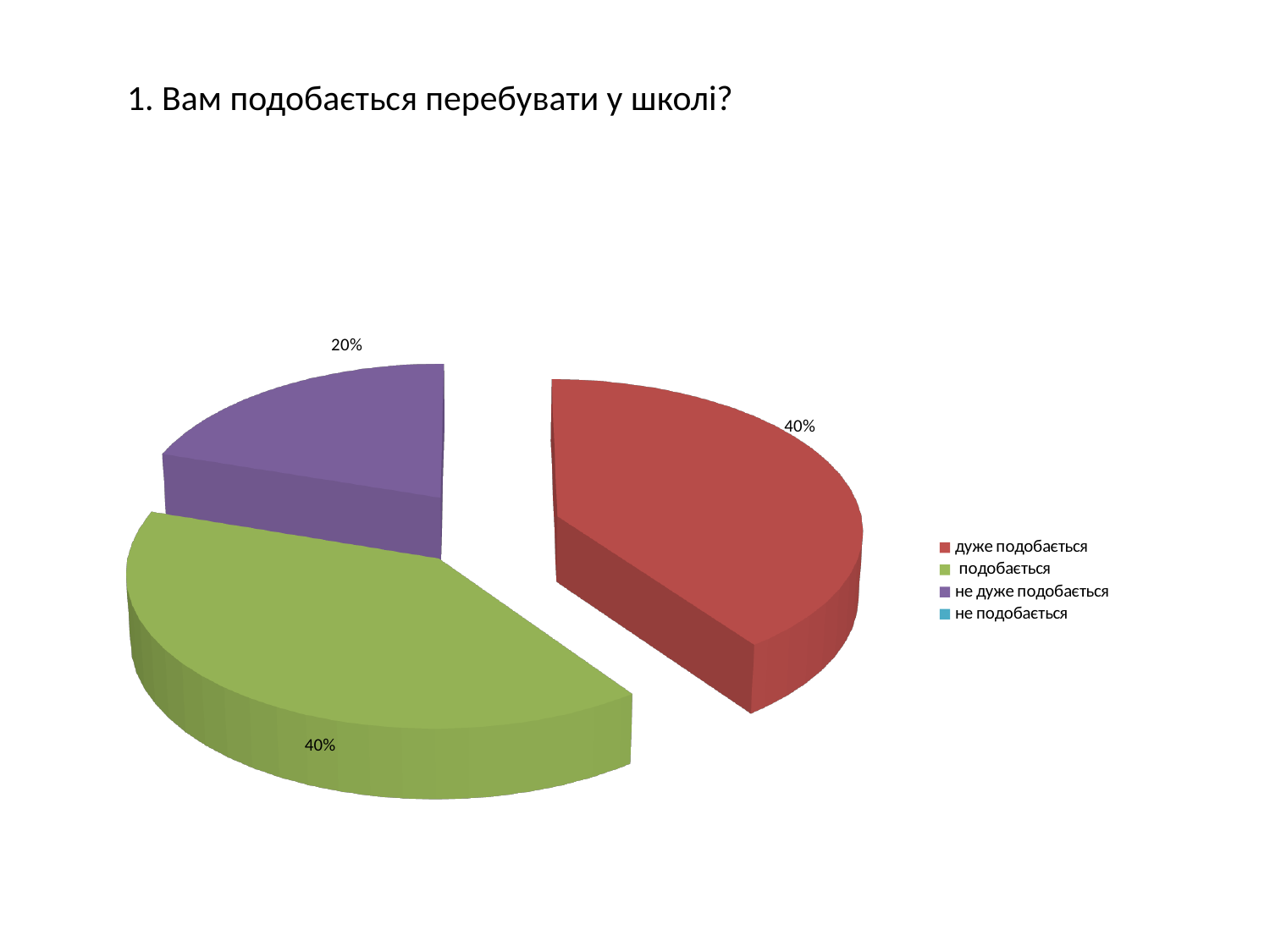
What percentage is shown for the "подобається" slice? 40% What is the title of the slide above the chart? 1. Вам подобається перебувати у школі? What percentage is shown for the "дуже подобається" slice? 40% How many entries does the legend list? 4 Which is larger, the share for "подобається" or the share for "не дуже подобається"? подобається What percentage is shown for the "не дуже подобається" slice? 20% Which is larger, the share for "дуже подобається" or the share for "не дуже подобається"? дуже подобається What type of chart is shown on the slide? pie chart How many slices are visible in the pie chart? 3 What is the difference between the share for "дуже подобається" and the share for "не дуже подобається"? 20% What colour is the "не дуже подобається" slice? purple